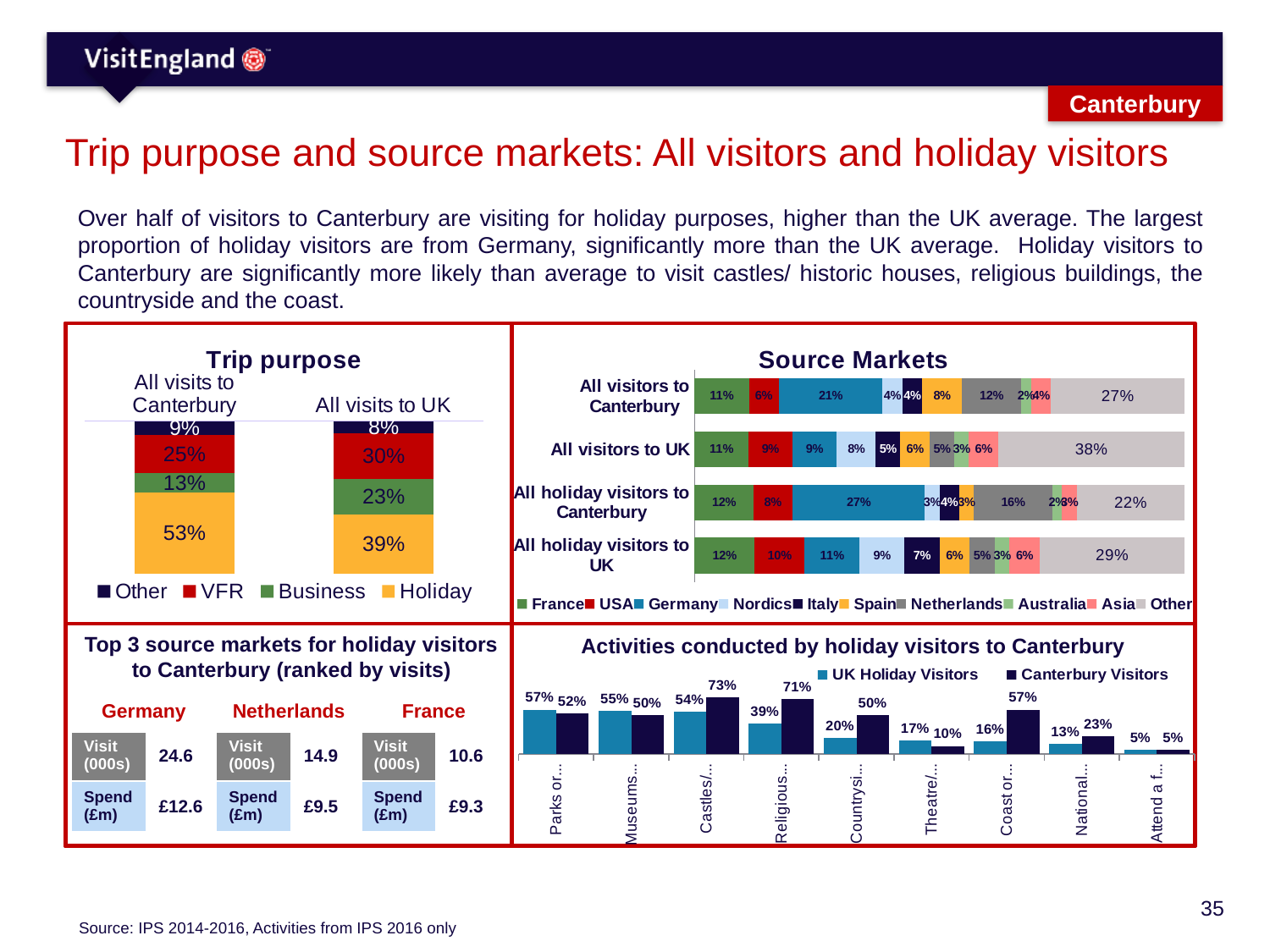
In the Source Markets chart, which is larger: the Netherlands share of all holiday visitors to Canterbury or of all holiday visitors to UK? All holiday visitors to Canterbury In the Source Markets chart, what percentage of all holiday visitors to Canterbury are from Germany? 27% In the Activities conducted by holiday visitors to Canterbury chart, what is the Canterbury Visitors value for Castles? 73% In the Activities conducted by holiday visitors to Canterbury chart, what is the difference between the Canterbury Visitors and UK Holiday Visitors values for Coast? 41 percentage points How many series does the legend of the Trip purpose chart list? 4 In the Activities conducted by holiday visitors to Canterbury chart, which activity has the highest value for UK Holiday Visitors? Parks or... In the Trip purpose chart, what is the difference between the Holiday share for all visits to Canterbury and for all visits to UK? 14 percentage points How many series does the legend of the Source Markets chart list? 10 In the Source Markets chart, what percentage of all visitors to UK fall into the Other category? 38% What kind of chart is the Activities conducted by holiday visitors to Canterbury chart? Bar chart In the Trip purpose chart, what percentage of all visits to Canterbury are for holiday purposes? 53% In the Trip purpose chart, which is larger: the Business share for all visits to Canterbury or for all visits to UK? All visits to UK